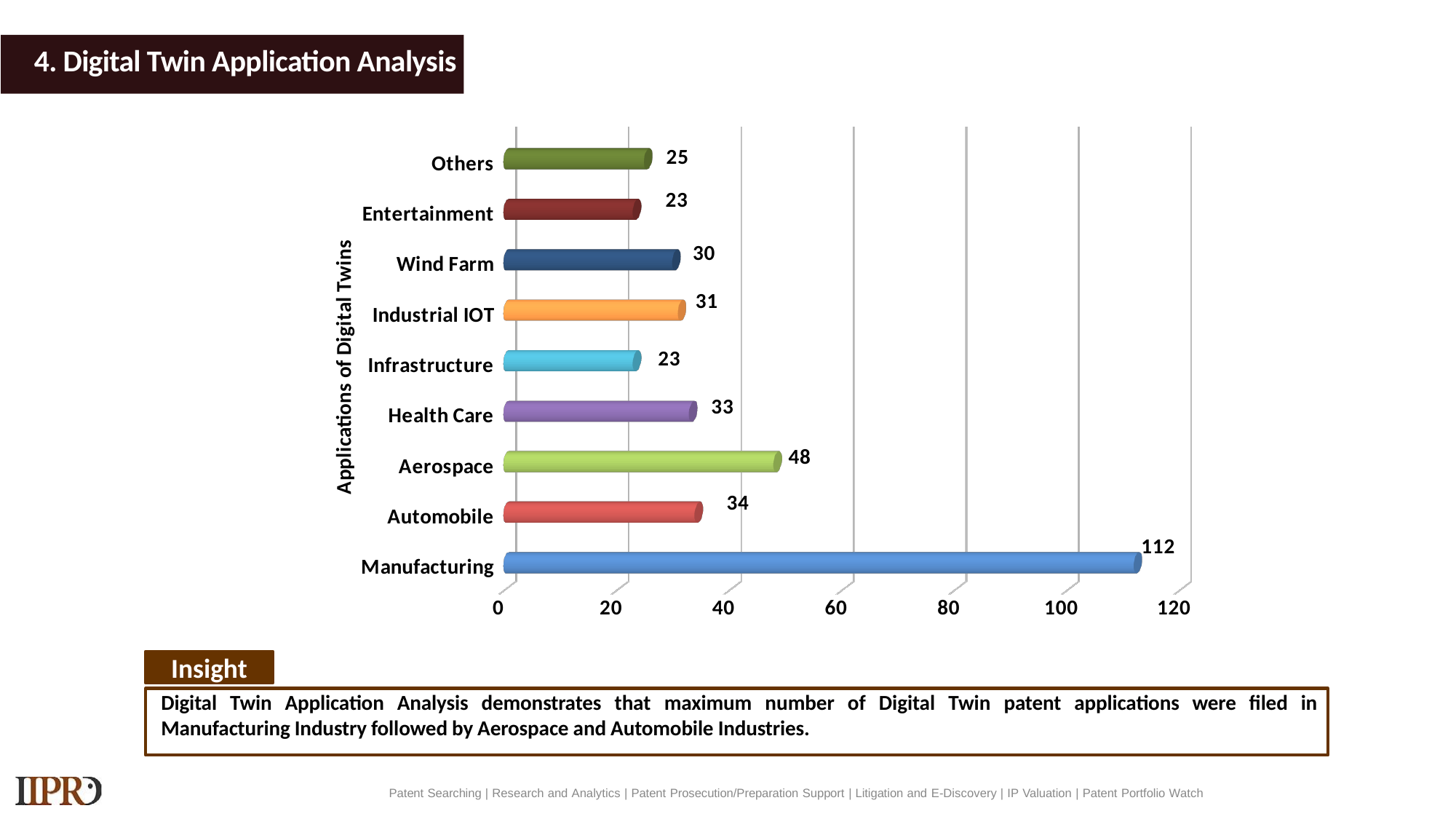
How many application categories are shown in the chart? 9 What kind of chart is shown on the slide? Bar chart What is the difference between the values for Manufacturing and Aerospace? 64 Which application has the highest value? Manufacturing What is the difference between the values for Automobile and Health Care? 1 Which application has the lowest value? Entertainment and Infrastructure (both 23) What is the value for Wind Farm? 30 Which is larger, the value for Aerospace or the value for Automobile? Aerospace Is the value for Manufacturing greater or less than 100? greater What is the label of the vertical axis of the chart? Applications of Digital Twins What is the value for Aerospace? 48 What is the value for Manufacturing? 112